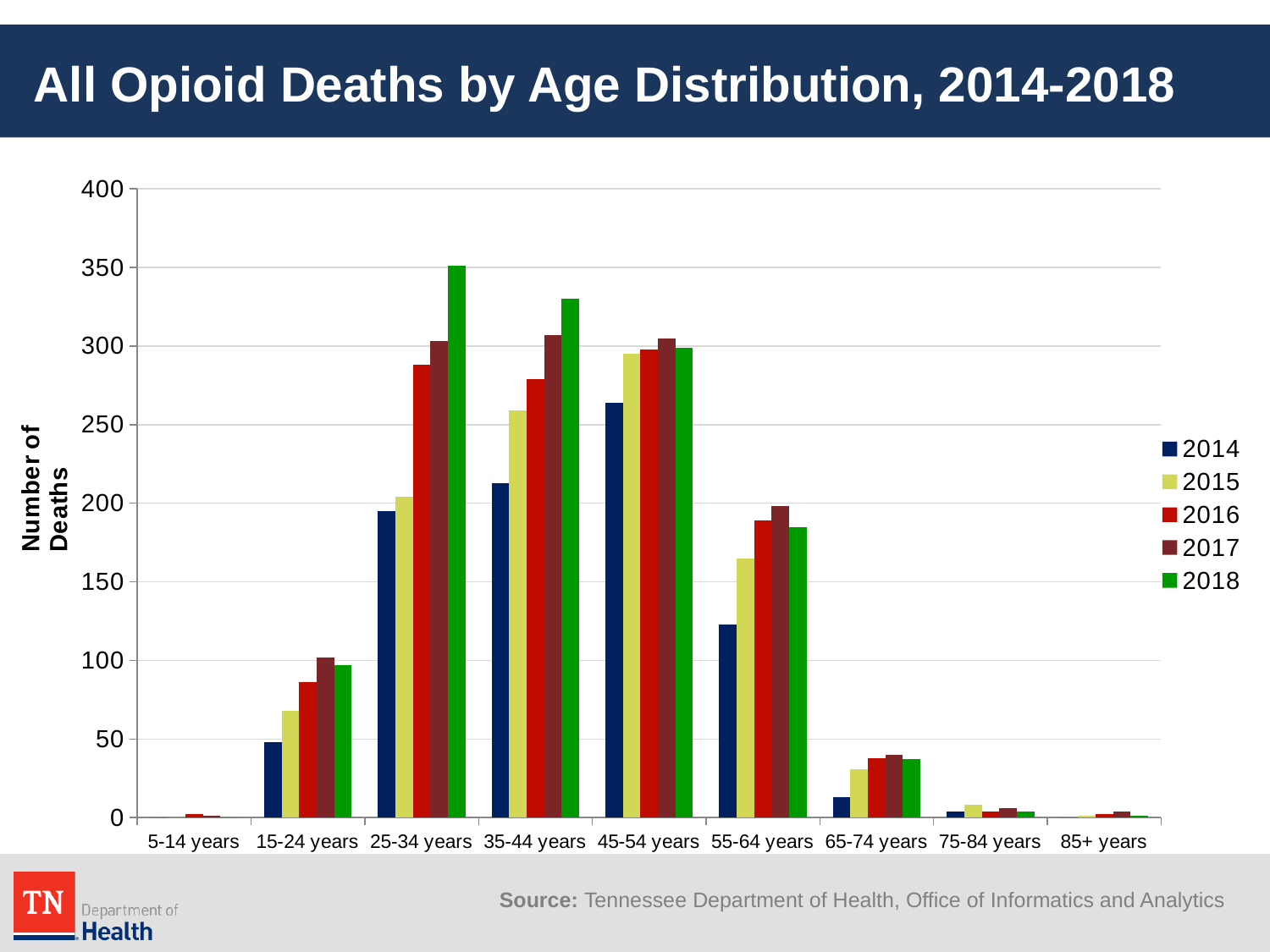
Is the value for 2018 in the 25-34 years group greater or less than 300? greater How many series does the legend list? 5 What kind of chart is shown on the slide? Bar chart Is the value for 2016 in the 35-44 years group greater or less than 250? greater Which age group has the highest number of deaths in 2018? 25-34 years In the 15-24 years group, which is larger: the 2014 value or the 2018 value? 2018 What is the title of the y axis? Number of Deaths For the 25-34 years group, do the values rise or fall from 2014 to 2018? rise Is the value for 2014 in the 55-64 years group greater or less than 150? less How many age groups are shown on the x axis? 9 Which year has the lowest number of deaths in the 55-64 years group? 2014 In the 25-34 years group, which is larger: the 2015 value or the 2016 value? 2016